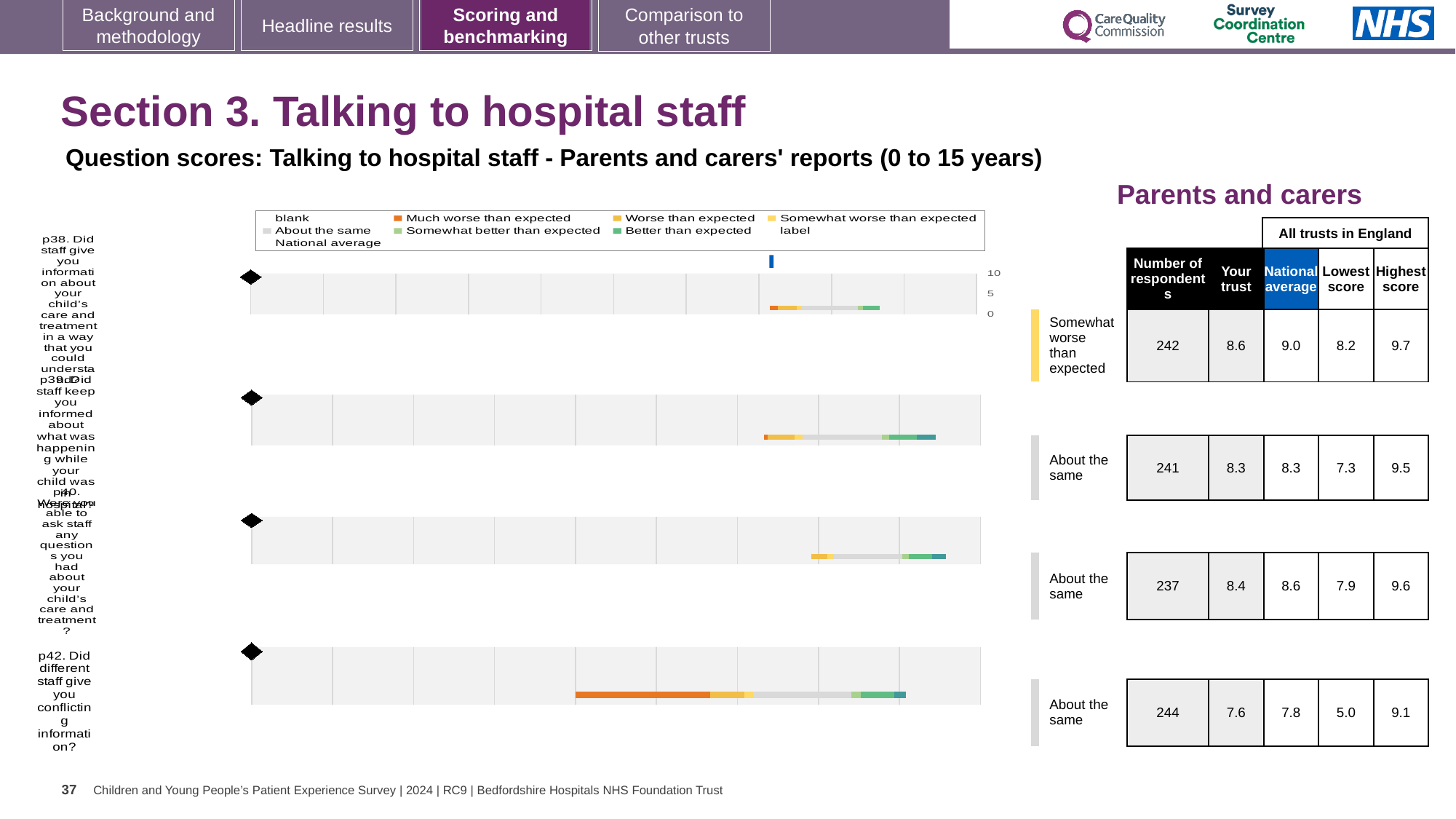
What kind of chart is used to show the question scores on this slide? bar chart What is the national average score for question p42 (Did different staff give you conflicting information)? 7.8 What is the difference between the highest score and the lowest score across all trusts in England for question p42? 4.1 What is the lowest score across all trusts in England for question p40 (Were you able to ask staff any questions you had about your child's care and treatment)? 7.9 Which question has the lowest 'Your trust' score? p42 What is the 'Your trust' score for question p38 (Did staff give you information about your child's care and treatment in a way that you could understand)? 8.6 What benchmark category is shown for question p38? Somewhat worse than expected Which question has the highest 'Your trust' score? p38 For question p38, which is larger: the 'Your trust' score or the national average? National average How many survey questions are plotted in the chart on this slide? 4 What colour does the legend use for 'Much worse than expected'? Orange How many respondents answered question p39 (Did staff keep you informed about what was happening while your child was in hospital)? 241